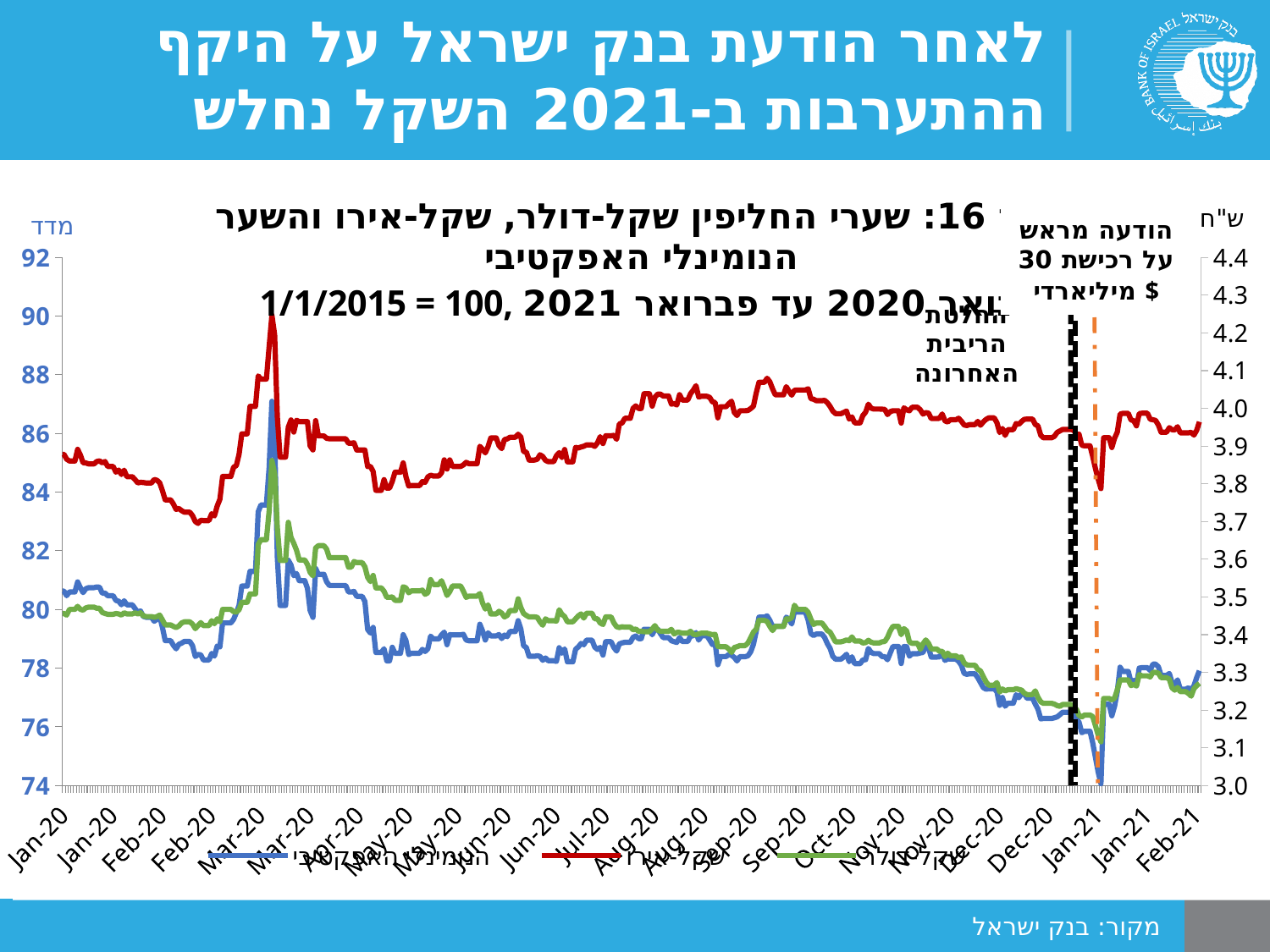
Is the peak of the red line in Mar-20, read on the right axis, greater or less than 4.0? greater Is the value of the red line at Jan-20, read on the right axis, greater or less than 4.2? less What is the highest tick value shown on the right axis (ש"ח)? 4.4 Around Jun-20, which line is higher on the left axis, the blue line or the green line? green Which line reaches a higher peak on the left axis in Mar-20, the blue line or the green line? blue What is the highest tick value shown on the left axis (מדד)? 92 Does the green line overall rise or fall from Jan-20 to Feb-21? fall Is the lowest point of the blue line in Jan-21, read on the left axis, greater or less than 76? less How many series (lines) are plotted on the chart? 3 What kind of chart is shown on the slide? line chart